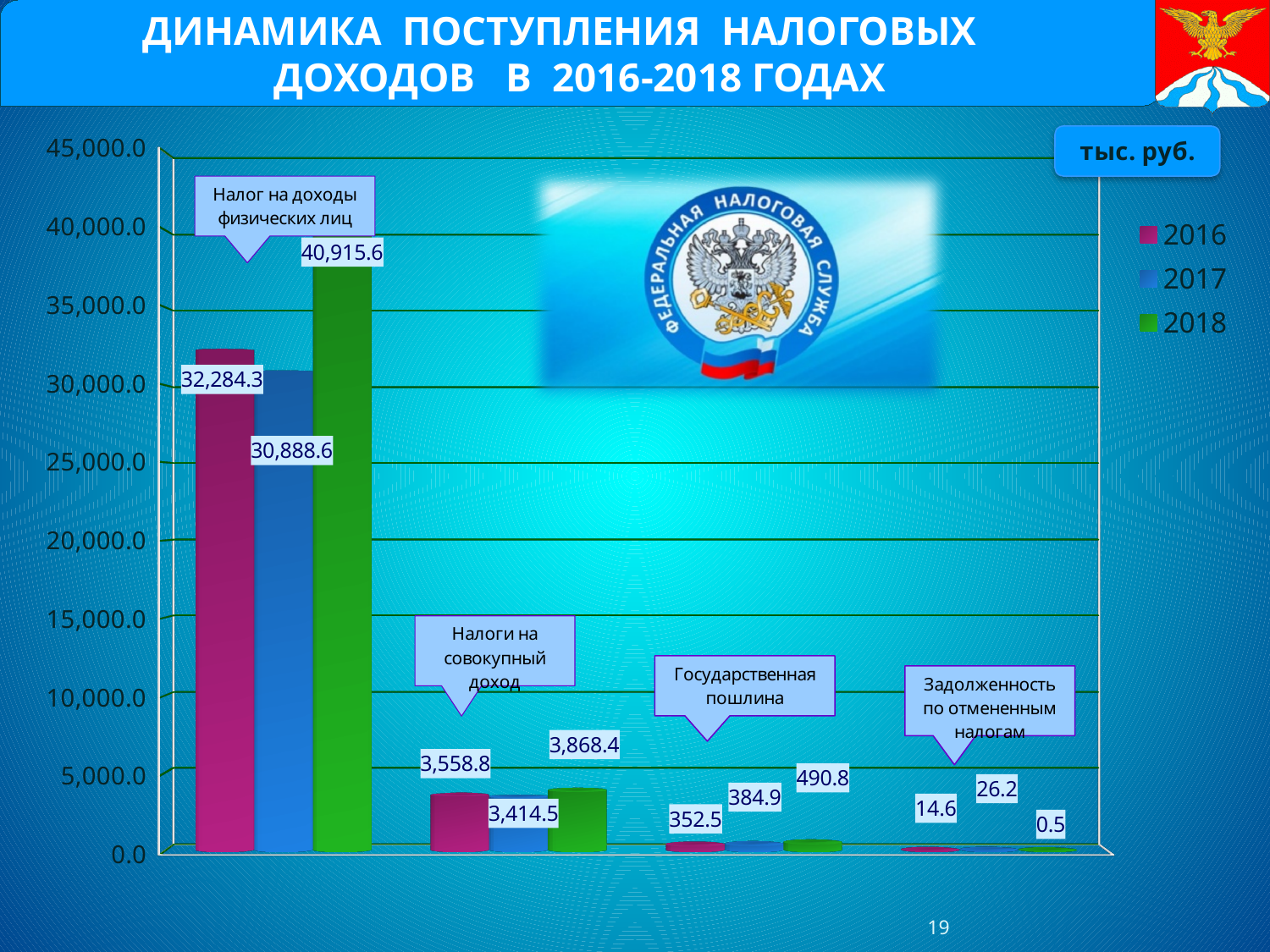
How many series does the legend list? 3 What kind of chart is shown on the slide? bar chart What is the difference between the 2018 and 2017 values for Налог на доходы физических лиц? 10,027.0 Which year has the highest value for Налог на доходы физических лиц? 2018 What is the 2018 value for Налог на доходы физических лиц? 40,915.6 Which year has the lowest value for Задолженность по отмененным налогам? 2018 Which is larger for Государственная пошлина: the 2017 value or the 2018 value? 2018 What is the 2017 value for Налоги на совокупный доход? 3,414.5 What unit is shown in the box at the top right of the chart? тыс. руб. What is the 2016 value for Государственная пошлина? 352.5 Is the 2016 value for Налог на доходы физических лиц greater or less than 30,000.0? greater What is the 2018 value for Задолженность по отмененным налогам? 0.5